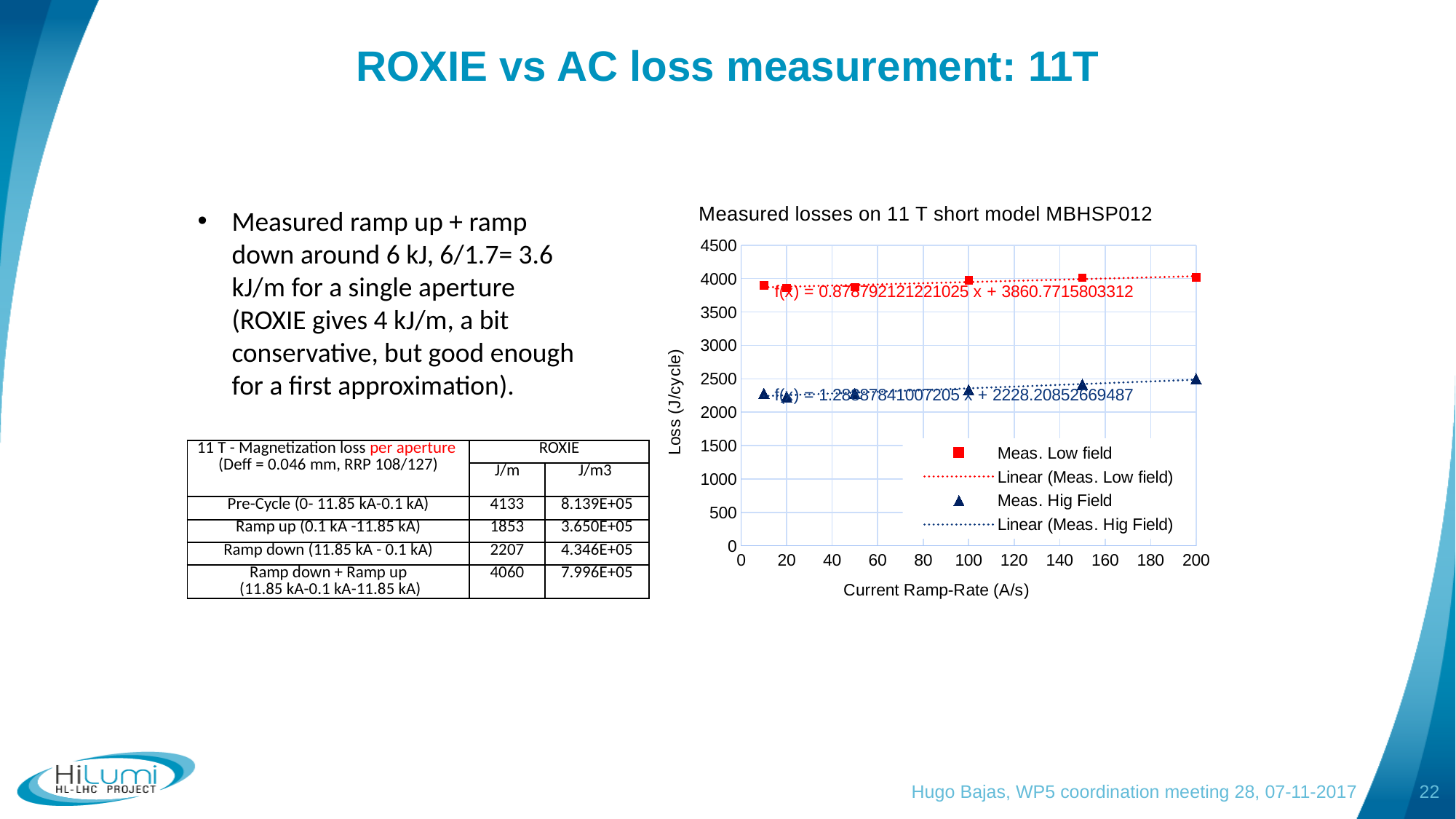
How many entries does the chart legend list? 4 What is the intercept shown in the trendline equation for the Meas. Low field series? 3860.7715803312 Is the Meas. Hig Field value at a ramp rate of 20 A/s greater or less than 2000 J/cycle? greater Which series has the lowest loss values overall, Meas. Low field or Meas. Hig Field? Meas. Hig Field How many measured data points are plotted for the Meas. Hig Field series? 6 What is the title of the chart? Measured losses on 11 T short model MBHSP012 Do the Meas. Hig Field losses rise or fall as the current ramp-rate increases? rise What kind of chart is shown on the slide? scatter chart At a ramp rate of 100 A/s, which series has the larger loss, Meas. Low field or Meas. Hig Field? Meas. Low field How many measured data points are plotted for the Meas. Low field series? 6 Is the Meas. Hig Field value at a ramp rate of 200 A/s greater or less than 3000 J/cycle? less Is the Meas. Low field value at a ramp rate of 200 A/s greater or less than 3500 J/cycle? greater